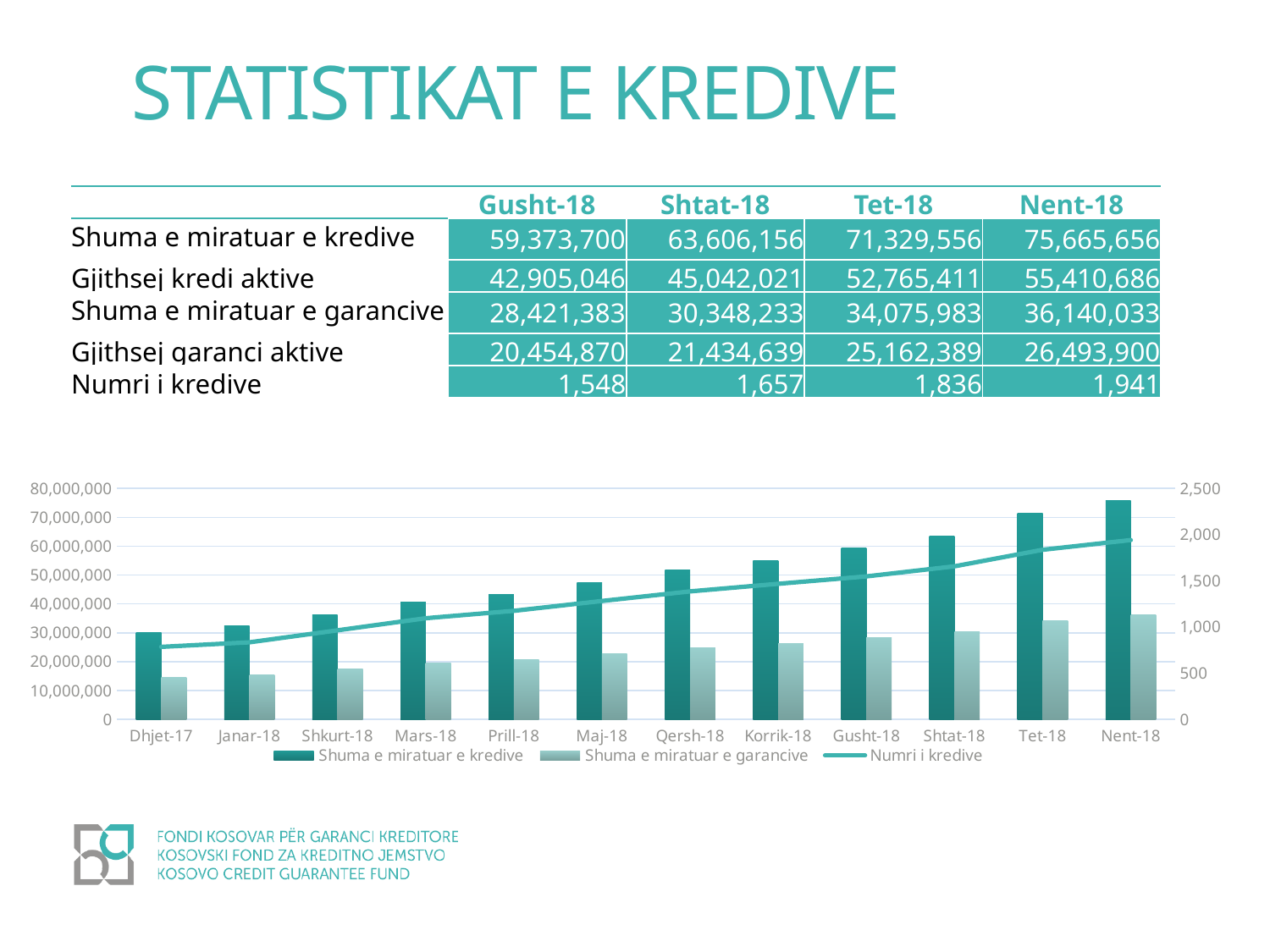
What kind of chart is shown on the slide? A bar chart combined with a line Which month has the lowest value for Shuma e miratuar e garancive in the chart? Dhjet-17 What is the difference in Shuma e miratuar e kredive between Nent-18 and Tet-18? 4,336,100 Is the value for Numri i kredive in Dhjet-17 greater or less than 1,000? less How many months are shown along the x axis of the chart? 12 By how much did Numri i kredive increase from Gusht-18 to Nent-18? 393 How many series does the chart legend list? 3 Is the value for Shuma e miratuar e kredive in Maj-18 greater or less than 50,000,000? less Does the Numri i kredive line rise or fall from Dhjet-17 to Nent-18? Rises What is the value of Shuma e miratuar e kredive for Nent-18? 75,665,656 Which month has the highest value for Shuma e miratuar e kredive in the chart? Nent-18 What is the value of Shuma e miratuar e garancive for Tet-18? 34,075,983